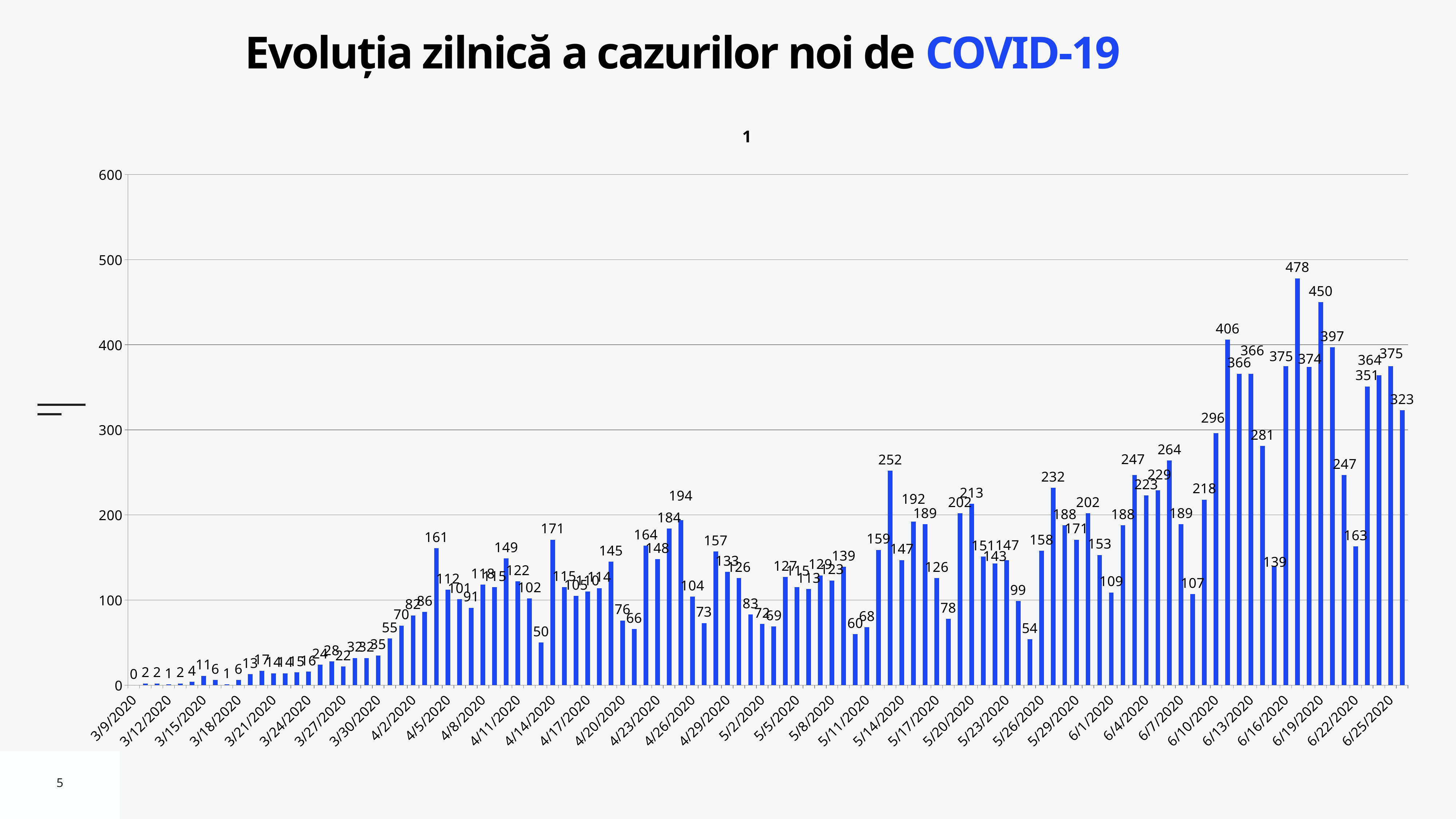
What is the highest daily value shown in the chart? 478 Which is larger, the value for 6/19/2020 or the value for 6/22/2020? 6/19/2020 What is the value for 6/13/2020? 366 Is the value for 6/10/2020 greater or less than 200? greater What is the value for 6/10/2020? 296 What is the value for 4/14/2020? 171 What kind of chart is shown on the slide? bar chart What is the value for 6/19/2020? 450 What is the title of the slide? Evoluția zilnică a cazurilor noi de COVID-19 What is the difference between the highest value (478) and the value for 6/19/2020? 28 What is the value for 3/9/2020? 0 Overall, do the values rise or fall from March to June along the x axis? rise